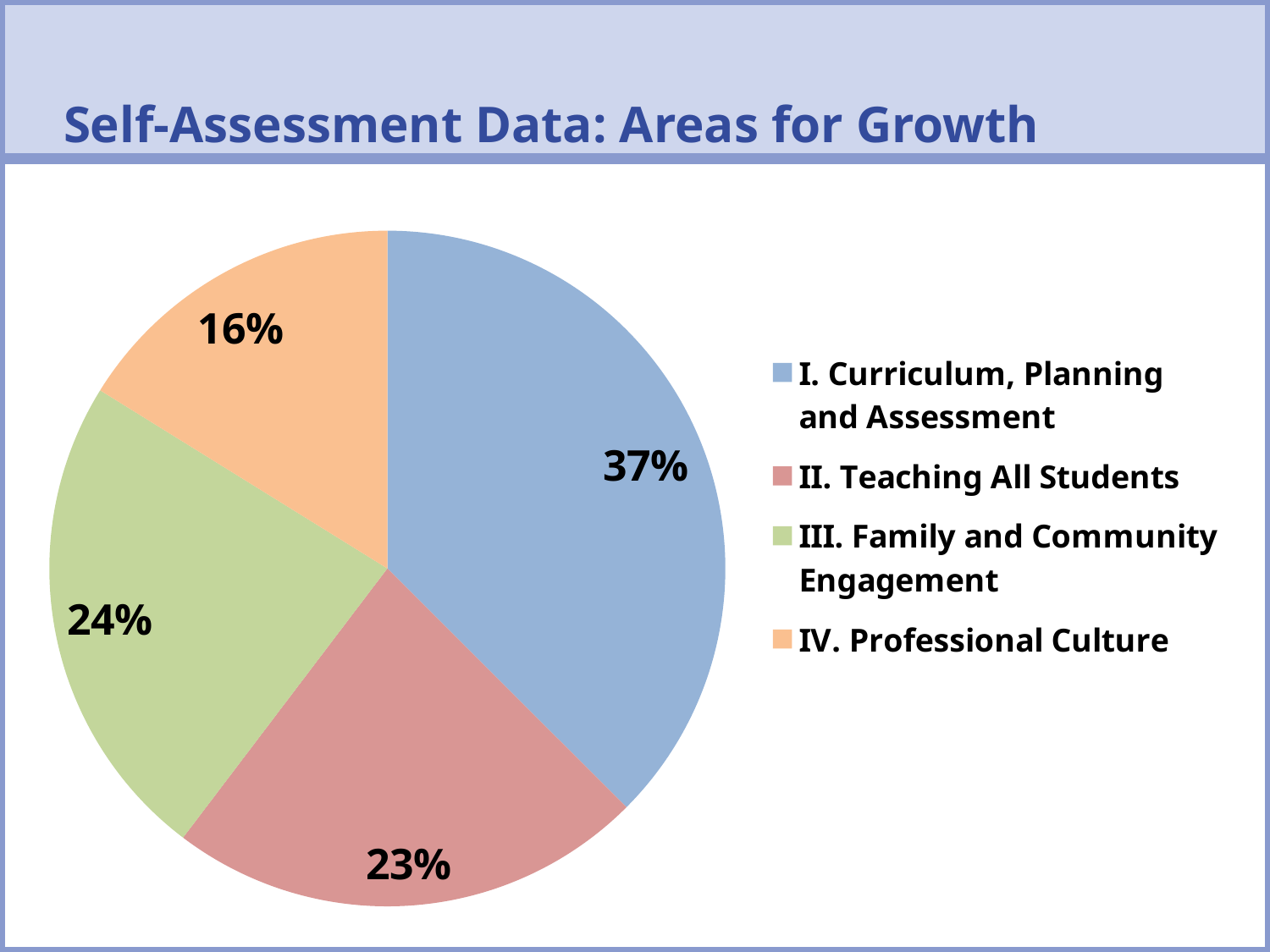
What is the difference in percentage points between I. Curriculum, Planning and Assessment and IV. Professional Culture? 21 Which category has the smallest slice of the pie? IV. Professional Culture What share of the pie does I. Curriculum, Planning and Assessment have? 37% What is the difference in percentage points between III. Family and Community Engagement and II. Teaching All Students? 1 What share of the pie does III. Family and Community Engagement have? 24% What kind of chart is shown on the slide? pie chart What share of the pie does IV. Professional Culture have? 16% Which category has the largest slice of the pie? I. Curriculum, Planning and Assessment What is the title of the slide containing the chart? Self-Assessment Data: Areas for Growth How many categories does the pie chart have? 4 Which is larger: the share for I. Curriculum, Planning and Assessment or the share for II. Teaching All Students? I. Curriculum, Planning and Assessment